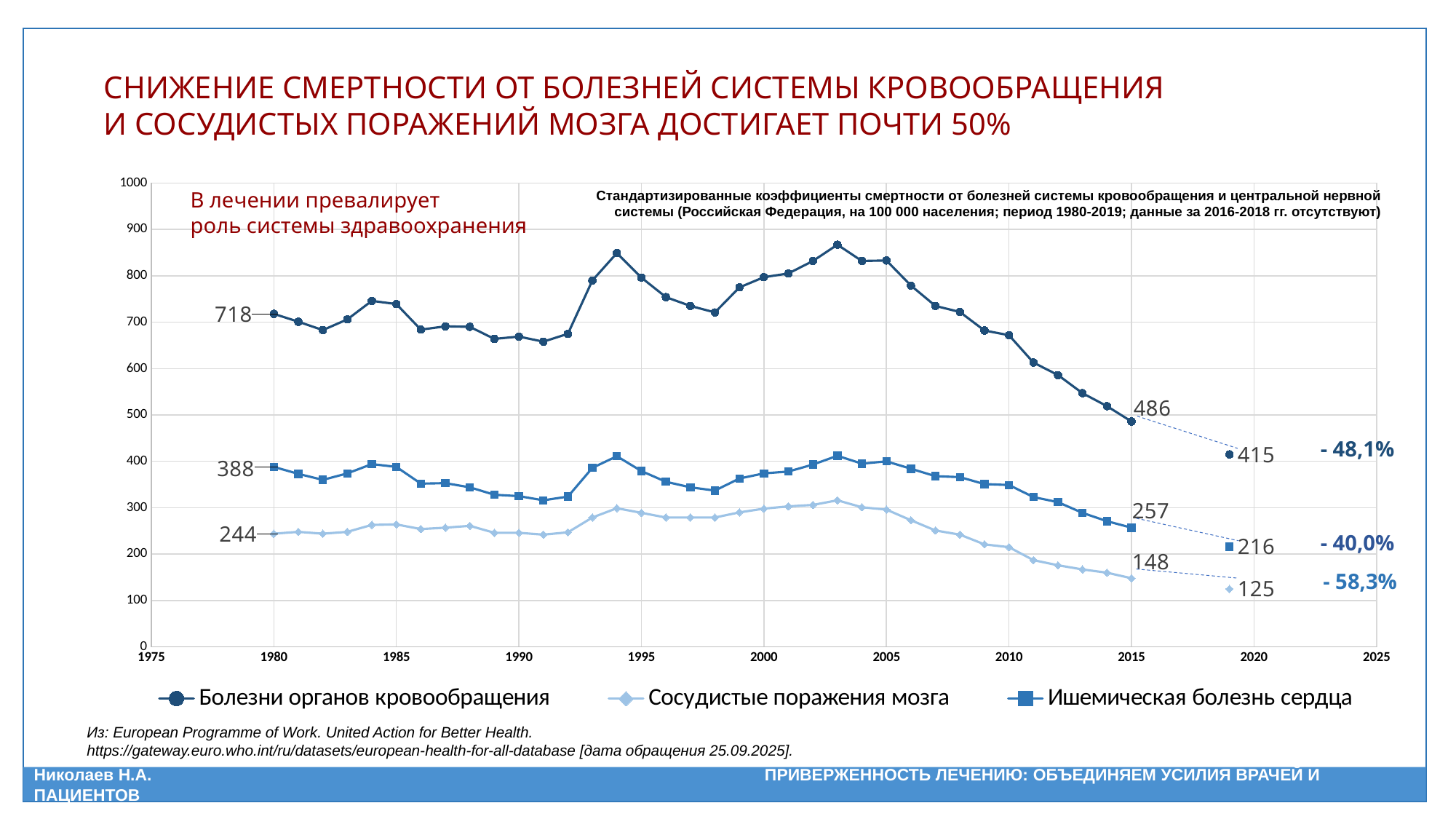
What is the difference between the 1980 and 2019 values for "Болезни органов кровообращения"? 303 What is the value for "Сосудистые поражения мозга" in 1980? 244 What is the value for "Болезни органов кровообращения" in 2015? 486 What is the value for "Сосудистые поражения мозга" in 2019? 125 What type of chart is shown on the slide? line chart Which series has the highest value in 2019? Болезни органов кровообращения What is the value for "Ишемическая болезнь сердца" in 2019? 216 Is the value for "Болезни органов кровообращения" in 2003 greater or less than 800? greater What percentage change is shown for "Сосудистые поражения мозга"? - 58,3% What is the value for "Болезни органов кровообращения" in 1980? 718 How many series does the legend list? 3 What is the difference between the 1980 and 2015 values for "Ишемическая болезнь сердца"? 131